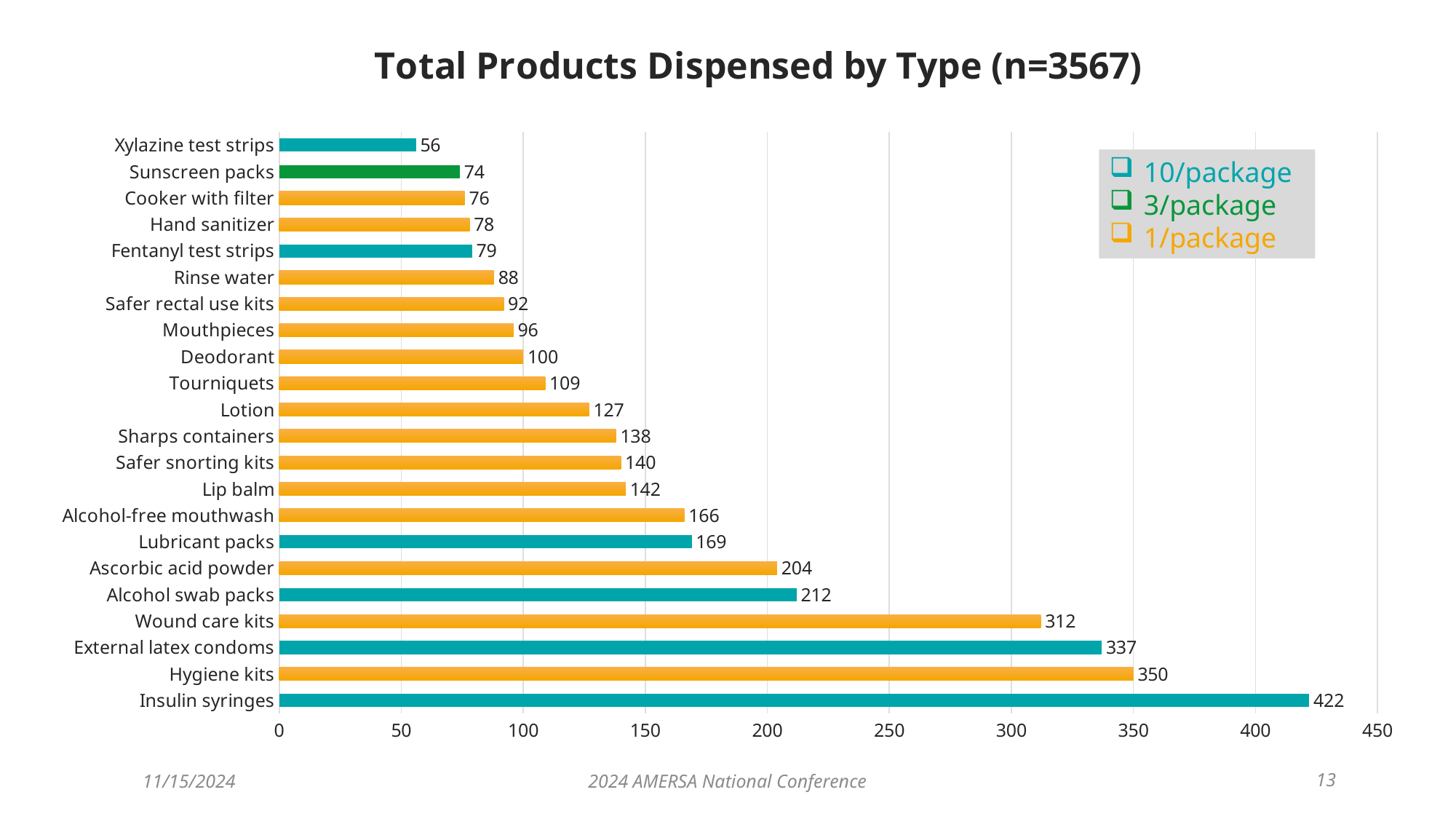
What kind of chart is shown on the slide? bar chart Is the value for Ascorbic acid powder greater or less than 200? greater How many series does the legend list? 3 What is the value for Insulin syringes? 422 Which product has the highest value? Insulin syringes Which product has the lowest value? Xylazine test strips What is the title of the chart? Total Products Dispensed by Type (n=3567) What is the value for Hygiene kits? 350 Which is larger, the value for Wound care kits or the value for External latex condoms? External latex condoms What is the difference between the values for Insulin syringes and Hygiene kits? 72 How many product categories are shown in the chart? 22 What is the value for Fentanyl test strips? 79